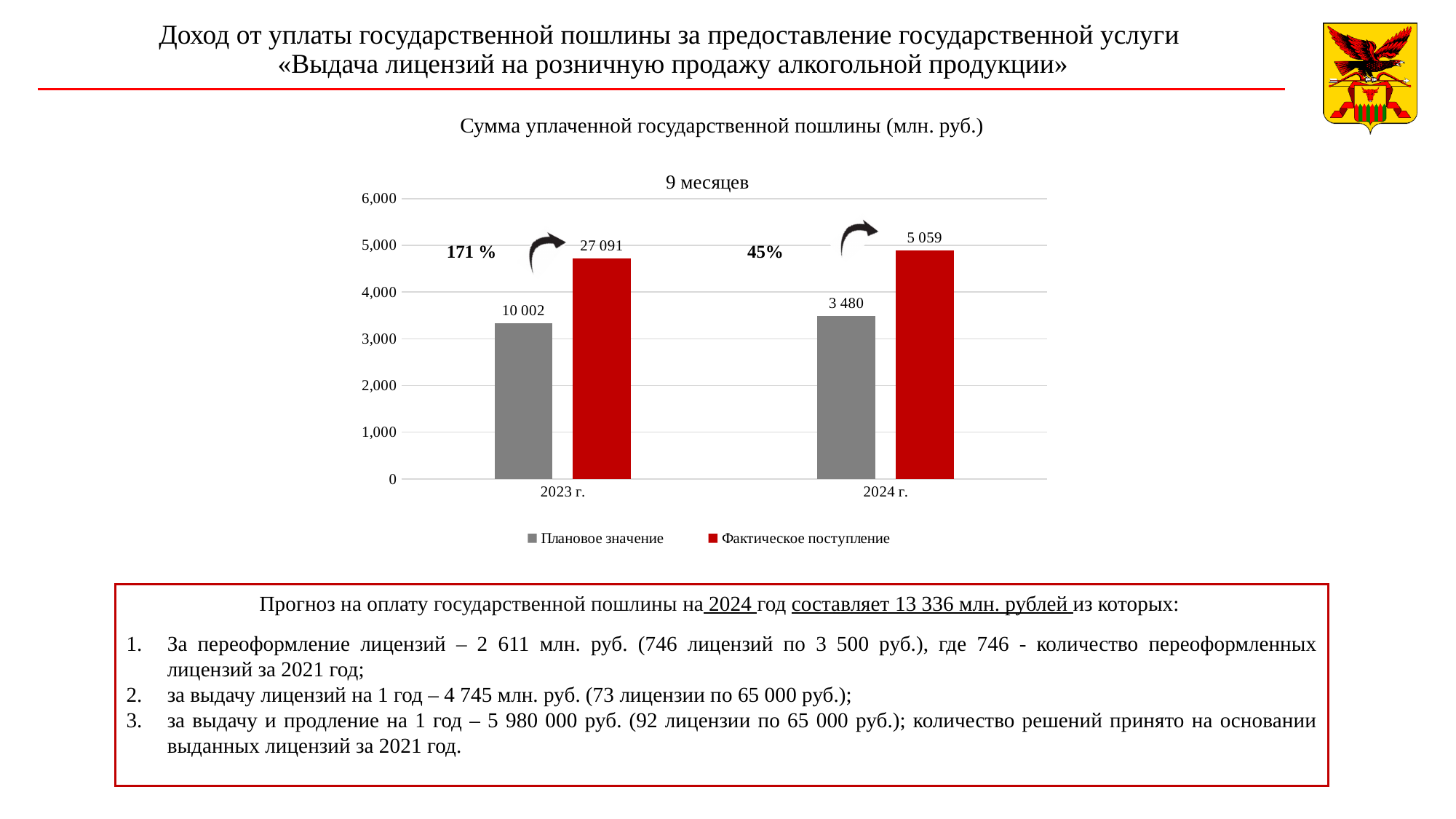
What is the data label for Фактическое поступление in 2024 г.? 5 059 In 2024 г., which is larger: Плановое значение or Фактическое поступление? Фактическое поступление What is the data label for Плановое значение in 2024 г.? 3 480 What is the difference between the labelled Фактическое поступление and Плановое значение values for 2024 г.? 1 579 How many series does the legend list? 2 What type of chart is shown on the slide? bar chart What is the title shown above the chart's plot area? 9 месяцев What is the data label for Фактическое поступление in 2023 г.? 27 091 How many year categories are shown on the x axis? 2 In 2023 г., which is larger: Плановое значение or Фактическое поступление? Фактическое поступление What is the data label for Плановое значение in 2023 г.? 10 002 Is the Плановое значение bar for 2024 г. greater or less than 3,000? greater